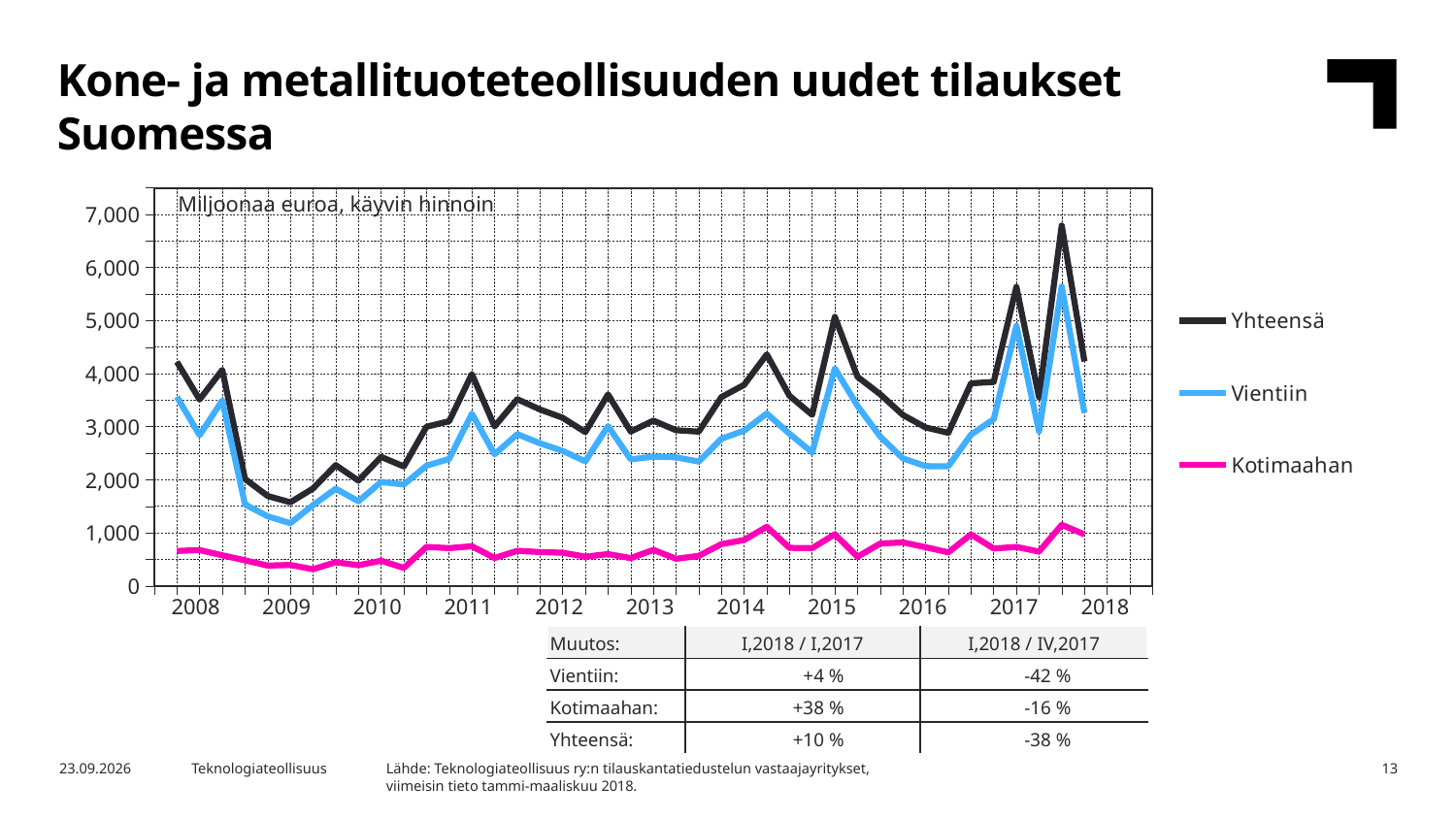
In 2017, which series is larger, Vientiin or Kotimaahan? Vientiin What kind of chart is shown on the slide? line chart How many series does the chart legend list? 3 Which series has the highest values throughout the whole period? Yhteensä What are the three series named in the chart legend? Yhteensä, Vientiin, Kotimaahan Which series has the lowest values throughout the whole period? Kotimaahan Is the highest value of the Kotimaahan line greater or less than 2,000? less Does the Yhteensä line rise or fall between the start of 2008 and the start of 2009? fall Is the value of the Vientiin line at the start of 2009 greater or less than 2,000? less Is the peak value of the Yhteensä line in late 2017 greater or less than 6,000? greater According to the table below the chart, what is the change for Vientiin for I,2018 / IV,2017? -42 % What unit is stated at the top of the chart area? Miljoonaa euroa, käyvin hinnoin